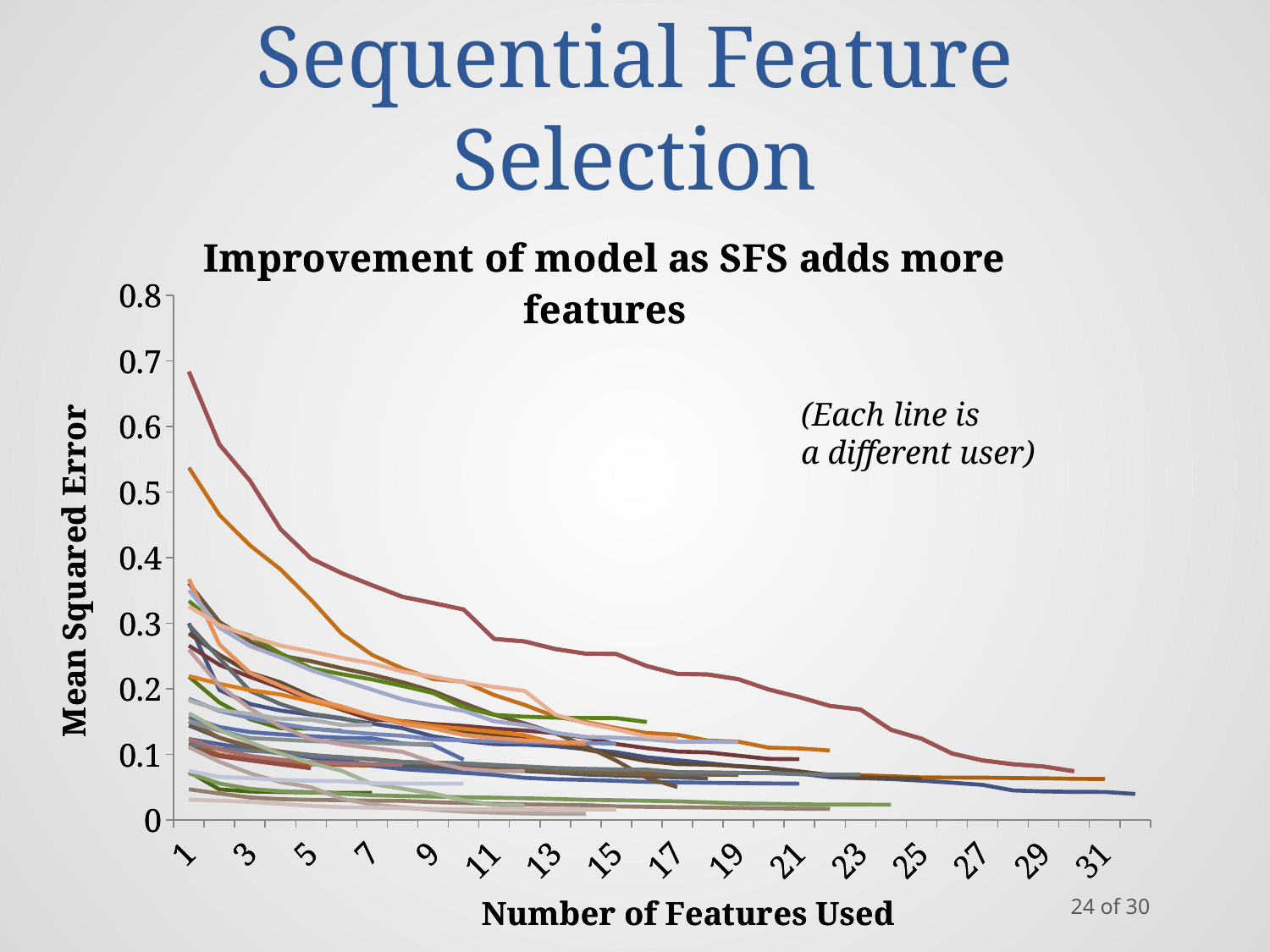
Do the lines generally rise or fall as the number of features used increases? fall What is the largest tick label shown on the x axis? 31 What is the highest value shown on the y axis? 0.8 Is the highest mean squared error shown at 11 features greater or less than 0.3? less Is the highest mean squared error shown at 1 feature greater or less than 0.6? greater Is the mean squared error of the longest line at 31 features greater or less than 0.1? less According to the note on the chart, what does each line represent? a different user What kind of chart is shown on the slide? line chart What is the title of the chart? Improvement of model as SFS adds more features